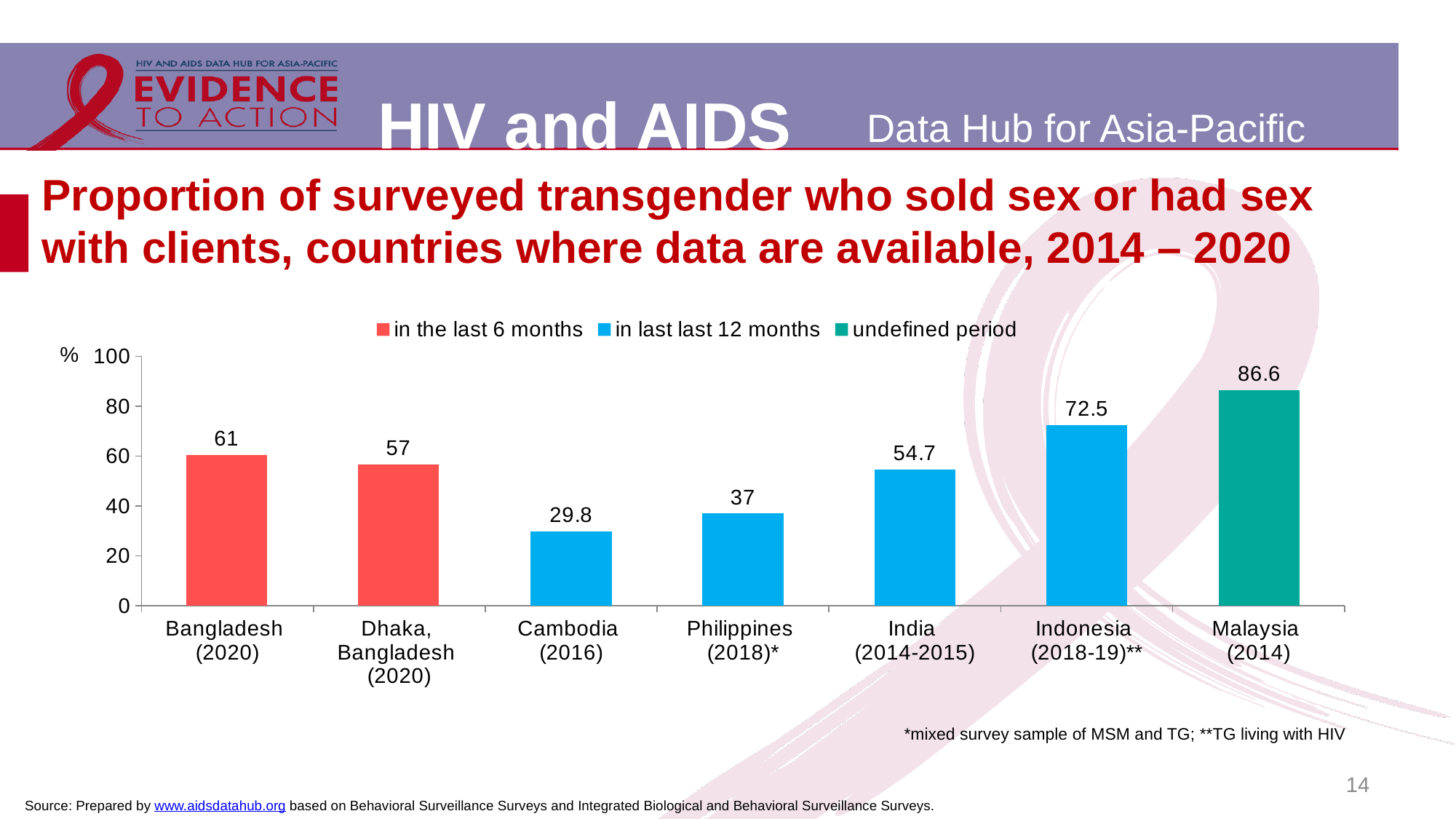
What is the difference between the values for Indonesia (2018-19)** and Philippines (2018)*? 35.5 Which category has the highest value? Malaysia (2014) Which category has the lowest value? Cambodia (2016) What is the value for Malaysia (2014)? 86.6 What is the value for Cambodia (2016)? 29.8 Which is larger, the value for Bangladesh (2020) or Dhaka, Bangladesh (2020)? Bangladesh (2020) Which legend series does the Malaysia (2014) bar belong to? undefined period Is the value for Indonesia (2018-19)** greater or less than 60? greater How many series does the legend list? 3 What kind of chart is shown on the slide? bar chart What is the value for India (2014-2015)? 54.7 How many categories are shown on the x axis? 7